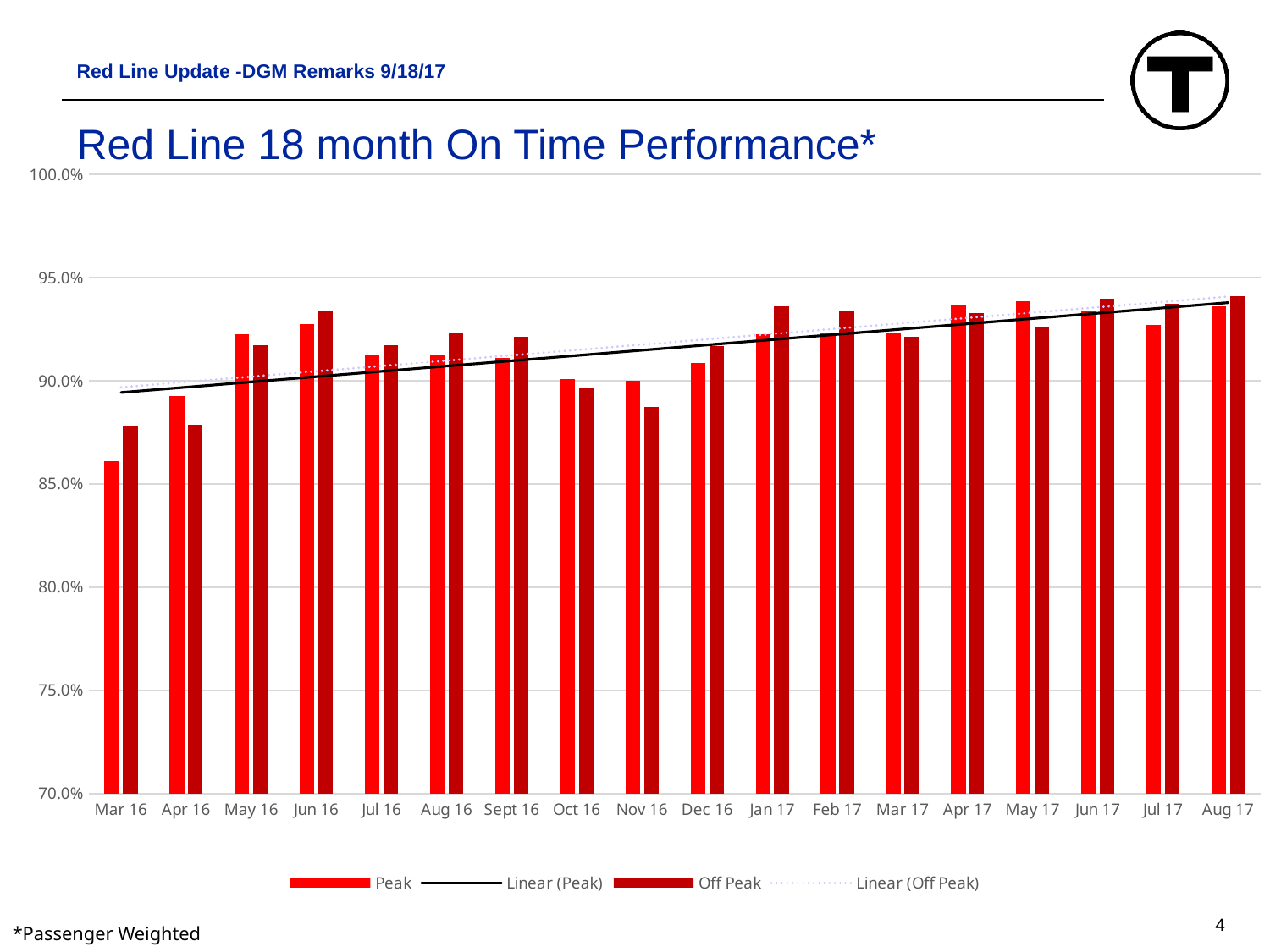
Is the Off Peak value for Nov 16 greater or less than 90.0%? less What is the title of the chart? Red Line 18 month On Time Performance* Is the Off Peak value for Jan 17 greater or less than 90.0%? greater Do the Peak and Off Peak trend lines rise or fall from Mar 16 to Aug 17? rise How many months are shown on the x axis of the chart? 18 What kind of chart is shown on the slide? bar chart In Nov 16, which is larger, the Peak or the Off Peak value? Peak Is the Peak value for Mar 16 greater or less than 85.0%? greater How many entries does the chart's legend list? 4 Which month has the lowest Peak on-time performance? Mar 16 In Mar 16, which is larger, the Peak or the Off Peak value? Off Peak